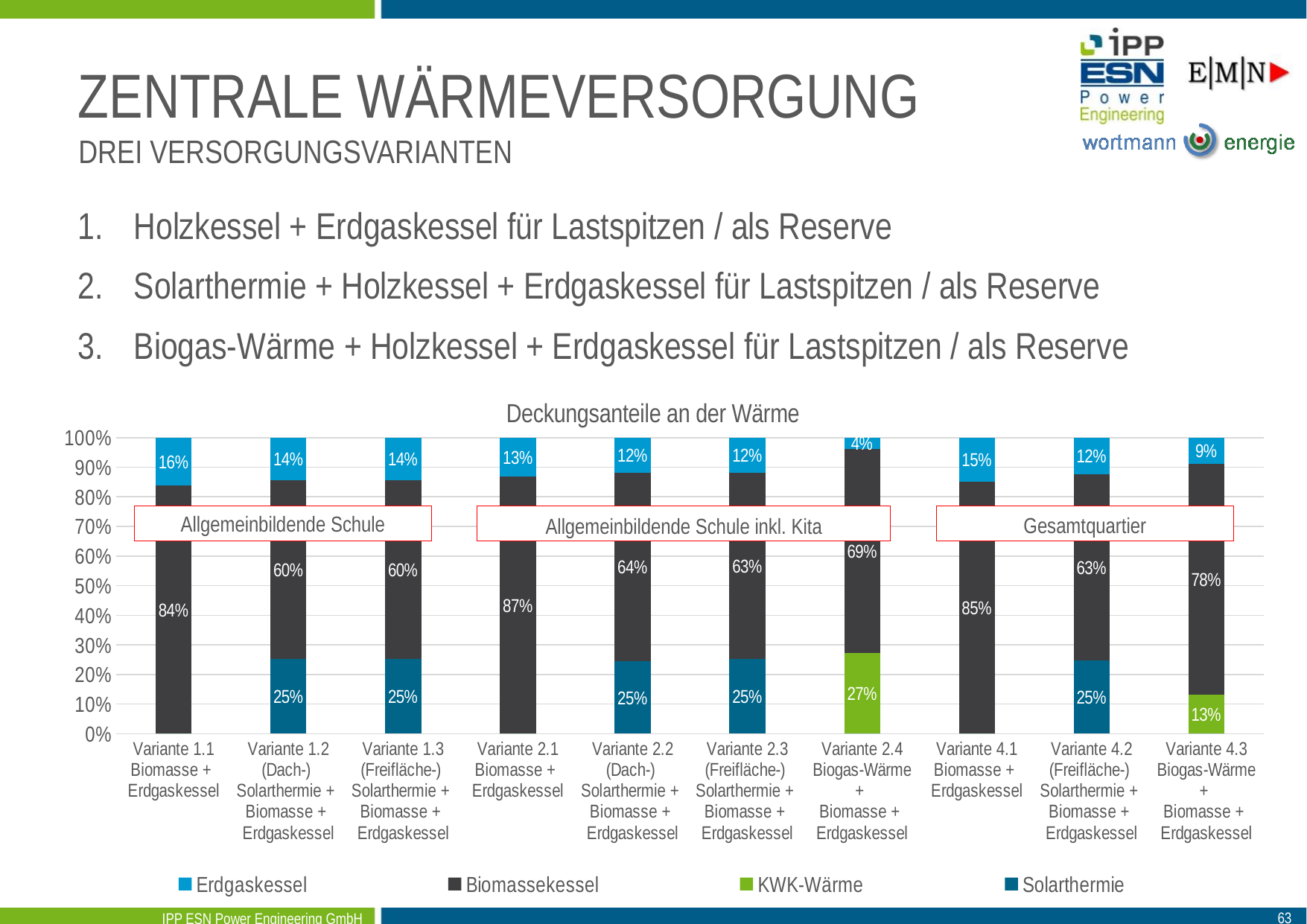
What is the title of the chart? Deckungsanteile an der Wärme What is the difference between the Biomassekessel share of Variante 4.3 and Variante 4.2? 15% What is the Solarthermie share for Variante 2.2? 25% What is the Biomassekessel share for Variante 1.1? 84% What type of chart is shown on the slide? Stacked bar chart Which variant has the lowest Erdgaskessel share? Variante 2.4 How many variants (bars) are shown in the chart? 10 Which is larger: the Erdgaskessel share of Variante 1.1 or of Variante 4.1? Variante 1.1 What is the Erdgaskessel share for Variante 2.4? 4% How many series does the chart legend list? 4 Which variant has the highest Biomassekessel share? Variante 2.1 What is the KWK-Wärme share for Variante 4.3? 13%